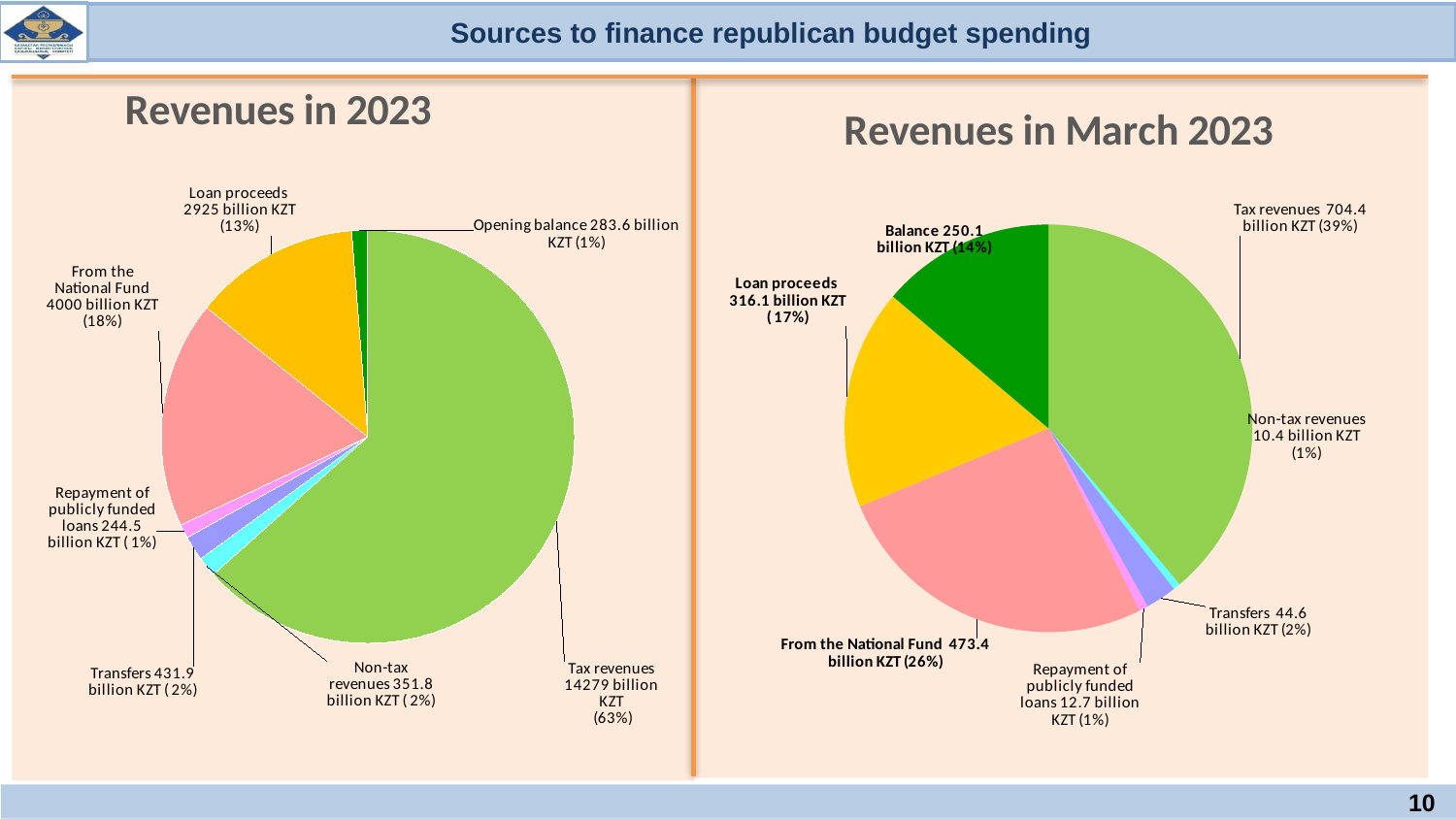
In the "Revenues in 2023" chart, what is the value for Tax revenues? 14279 billion KZT In the "Revenues in 2023" chart, which is larger, Transfers or Non-tax revenues? Transfers In the "Revenues in March 2023" chart, which category has the smallest value? Non-tax revenues In the "Revenues in 2023" chart, what is the value for Loan proceeds? 2925 billion KZT How many slices does the "Revenues in 2023" pie chart have? 7 In the "Revenues in March 2023" chart, what is the value for Tax revenues? 704.4 billion KZT In the "Revenues in March 2023" chart, what is the value for Balance? 250.1 billion KZT What kind of chart is the "Revenues in 2023" chart? Pie chart In the "Revenues in March 2023" chart, what share of the pie is From the National Fund? 26% In the "Revenues in 2023" chart, which category has the largest share? Tax revenues In the "Revenues in March 2023" chart, what is the difference between Loan proceeds and Balance? 66.0 billion KZT In the "Revenues in 2023" chart, what share of the pie is From the National Fund? 18%